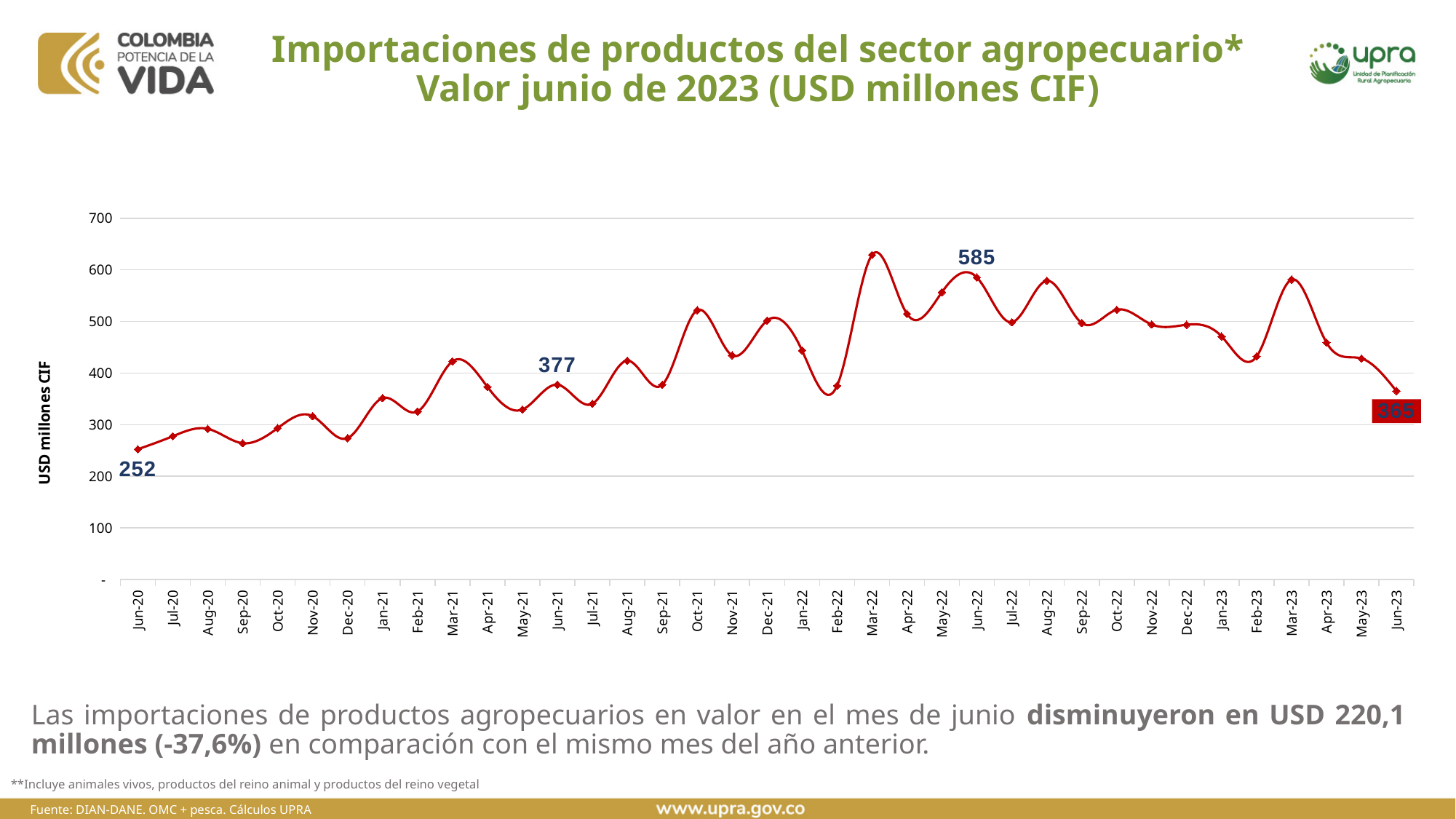
What is the value for Jun-21? 377 What is the difference between the values for Jun-21 and Jun-20? 125 Is the value for Feb-22 greater or less than 400? less What is the value for Jun-23? 365 Which is larger, the value for Jun-22 or the value for Jun-21? Jun-22 What is the value for Jun-20? 252 Which month has the highest value on the chart? Mar-22 What is the value for Jun-22? 585 What is the difference between the values for Jun-22 and Jun-23? 220 Is the value for Mar-22 greater or less than 600? greater What type of chart is shown on the slide? Line chart What is the label of the vertical axis? USD millones CIF